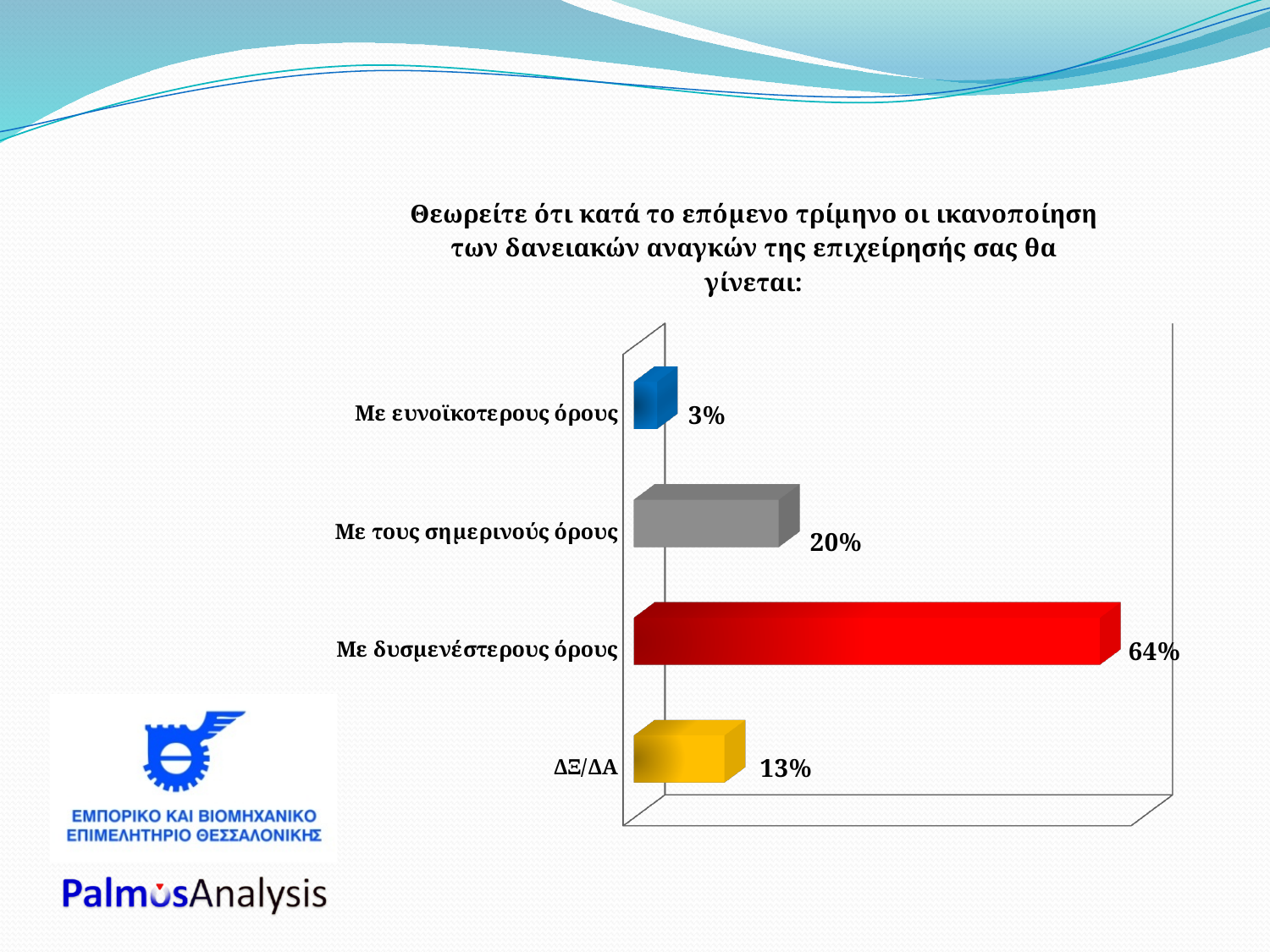
Which is larger, the value for "ΔΞ/ΔΑ" or the value for "Με ευνοϊκοτερους όρους"? ΔΞ/ΔΑ What kind of chart is shown on the slide? Bar chart What is the difference between the values for "Με δυσμενέστερους όρους" and "Με τους σημερινούς όρους"? 44% What is the value for "Με δυσμενέστερους όρους"? 64% What colour is the bar for "Με δυσμενέστερους όρους"? Red Which category has the lowest value? Με ευνοϊκοτερους όρους Which category has the highest value? Με δυσμενέστερους όρους What is the value for "Με τους σημερινούς όρους"? 20% What is the difference between the values for "Με τους σημερινούς όρους" and "ΔΞ/ΔΑ"? 7% What is the value for "ΔΞ/ΔΑ"? 13% What is the value for "Με ευνοϊκοτερους όρους"? 3% How many categories are shown in the chart? 4